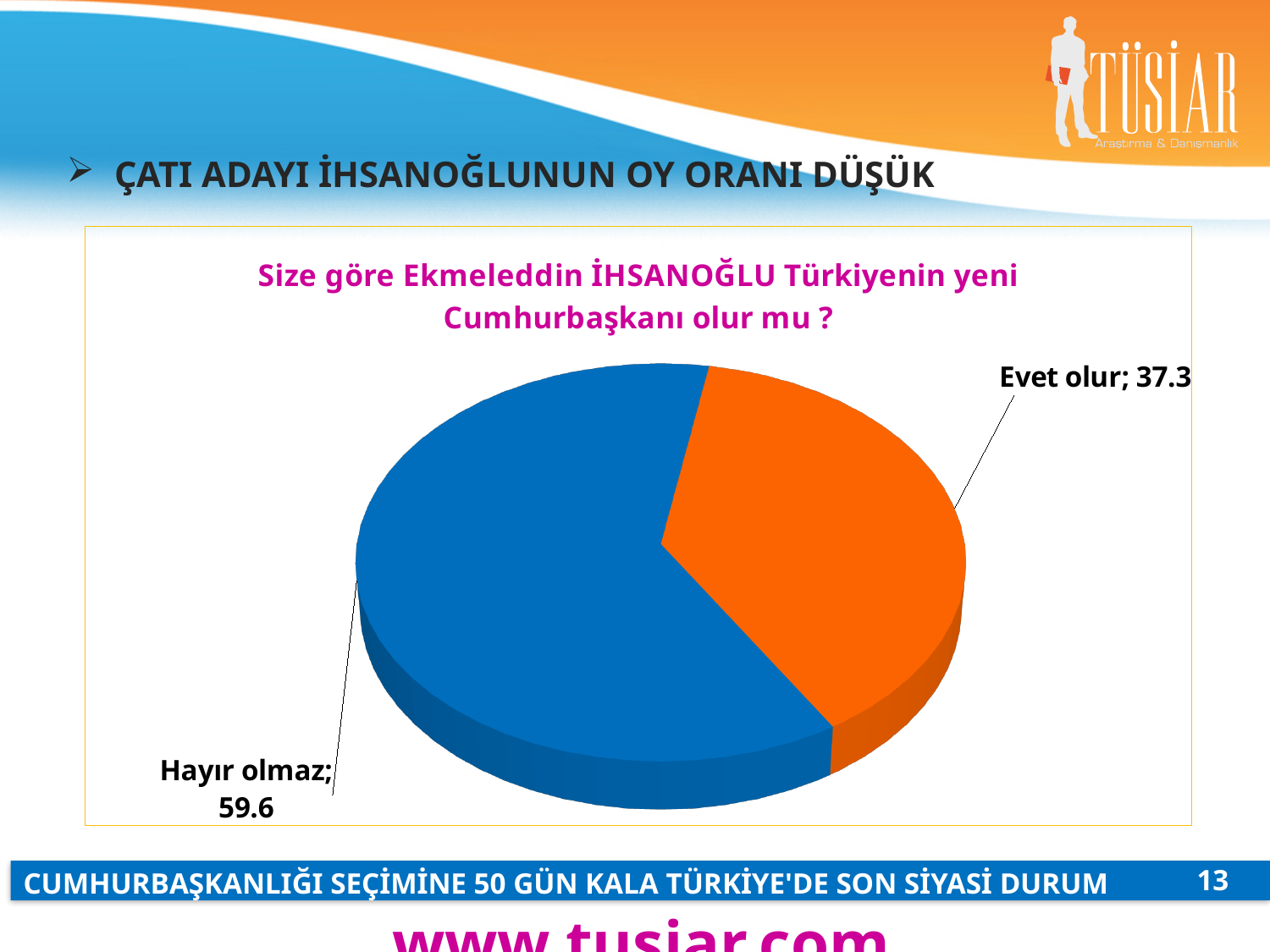
What value is shown for the "Evet olur" slice of the pie chart? 37.3 Which slice of the pie chart is the largest? Hayır olmaz What is the difference between the "Hayır olmaz" value and the "Evet olur" value in the pie chart? 22.3 Is the value for "Evet olur" in the pie chart greater or less than 50? less Which is larger in the pie chart, "Evet olur" or "Hayır olmaz"? Hayır olmaz What colour is the "Evet olur" slice of the pie chart? Orange What is the title of the chart on the slide? Size göre Ekmeleddin İHSANOĞLU Türkiyenin yeni Cumhurbaşkanı olur mu ? Which slice of the pie chart is the smallest? Evet olur Is the value for "Hayır olmaz" in the pie chart greater or less than 50? greater What kind of chart is shown on the slide? Pie chart How many slices does the pie chart have? 2 What value is shown for the "Hayır olmaz" slice of the pie chart? 59.6